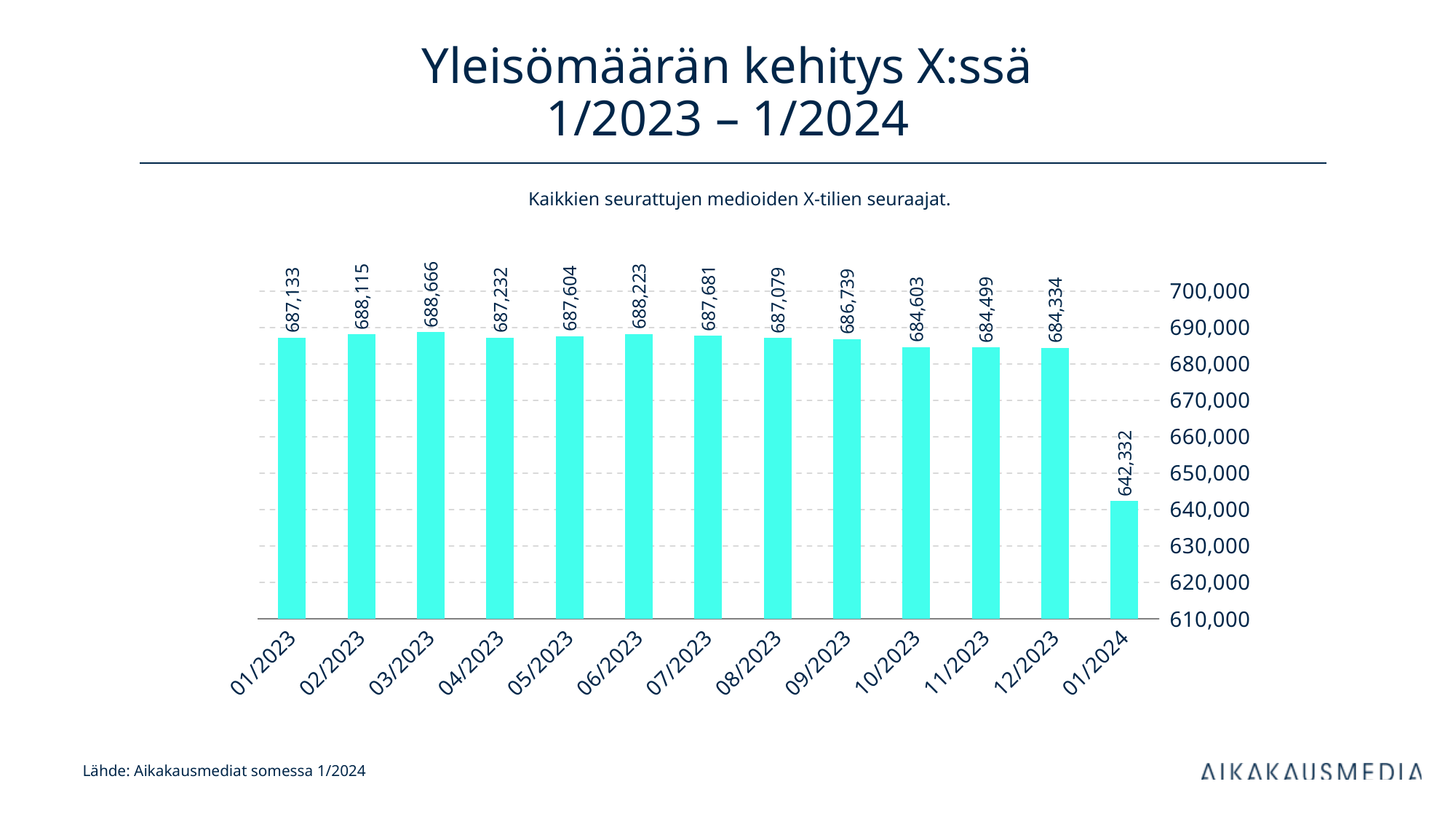
What is the difference between the values for 03/2023 and 01/2023? 1,533 What is the title of the chart? Yleisömäärän kehitys X:ssä 1/2023 – 1/2024 What is the difference between the values for 12/2023 and 01/2024? 42,002 How many months are shown on the x axis? 13 What is the value for 09/2023? 686,739 Is the value for 01/2024 greater or less than 650,000? less What kind of chart is shown on the slide? bar chart Which month has the lowest value? 01/2024 Which is larger, the value for 02/2023 or the value for 03/2023? 03/2023 What is the value for 01/2023? 687,133 Which month has the highest value? 03/2023 What is the value for 01/2024? 642,332